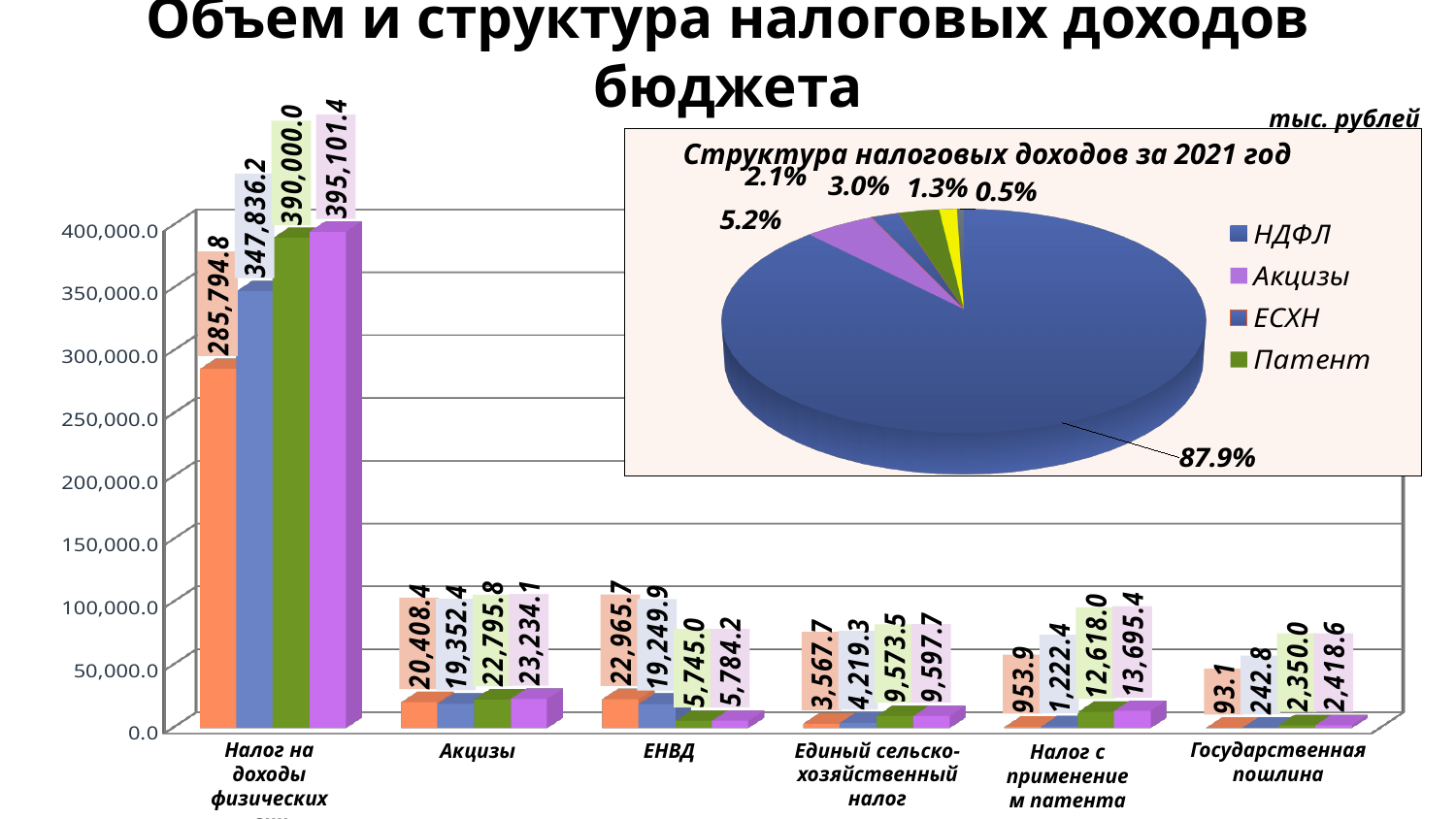
What type of chart is the large chart on the left of the slide? bar chart In the bar chart, what is the value of the blue bar for 'Государственная пошлина'? 242.8 In the bar chart, which category has the highest values? Налог на доходы физических лиц In the bar chart, what is the value of the orange bar for 'Акцизы'? 20,408.4 In the bar chart, what is the difference between the purple and orange bars for 'Налог на доходы физических лиц'? 109,306.6 In the bar chart, which is larger for 'ЕНВД': the orange bar or the green bar? orange bar How many entries does the legend of the pie chart 'Структура налоговых доходов за 2021 год' list? 4 What type of chart is titled 'Структура налоговых доходов за 2021 год'? pie chart How many categories are shown on the x axis of the bar chart? 6 In the bar chart, what is the value of the green bar for 'Налог с применением патента'? 12,618.0 In the pie chart 'Структура налоговых доходов за 2021 год', what share does the largest slice have? 87.9% In the bar chart, what is the value of the purple bar for 'Налог на доходы физических лиц'? 395,101.4